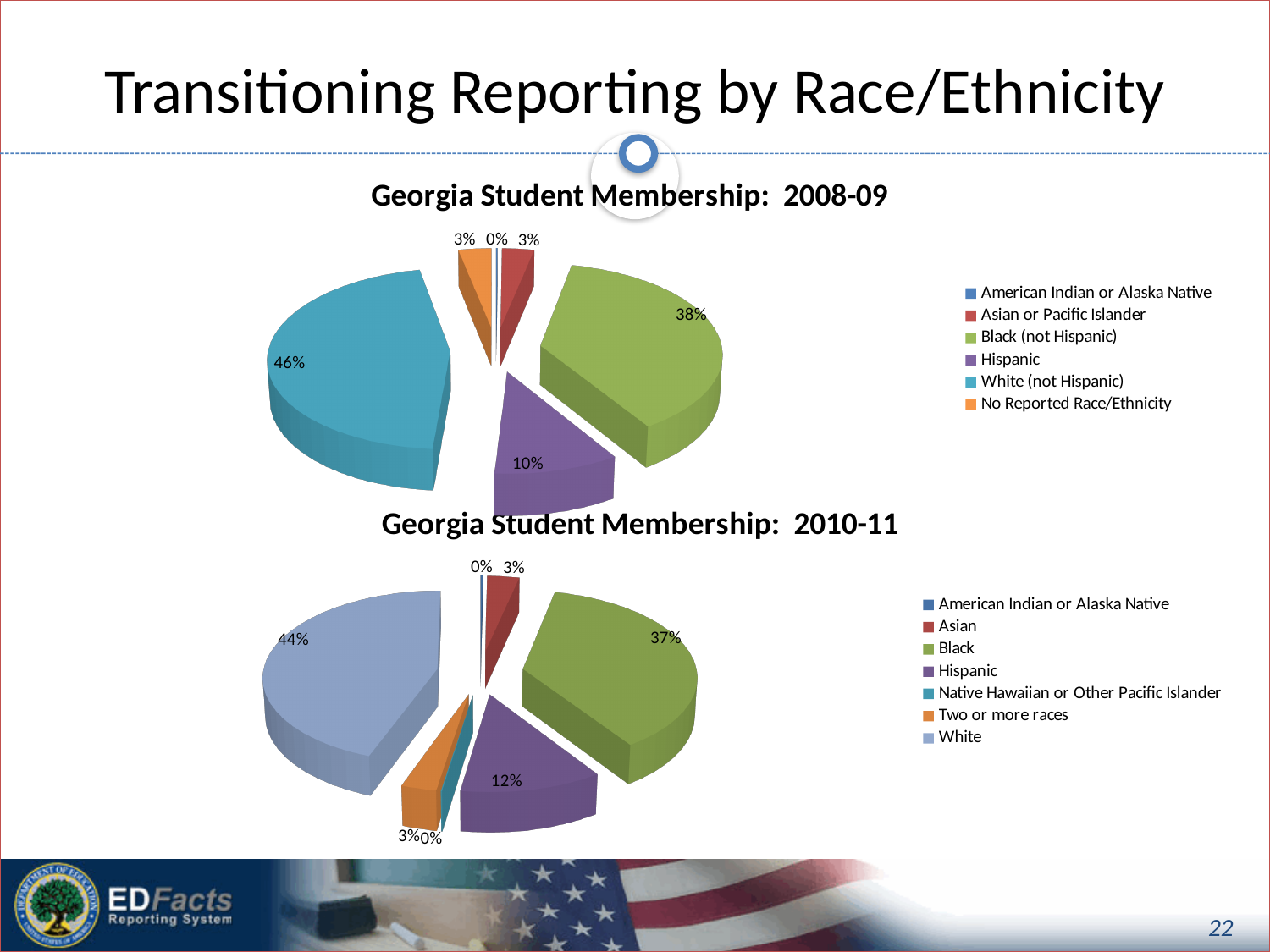
In the 'Georgia Student Membership: 2008-09' chart, what share is Black (not Hispanic)? 38% In the 'Georgia Student Membership: 2008-09' chart, what share is White (not Hispanic)? 46% How many categories does the legend of the 'Georgia Student Membership: 2008-09' chart list? 6 What type of chart is used for 'Georgia Student Membership: 2010-11'? Pie chart How many categories does the legend of the 'Georgia Student Membership: 2010-11' chart list? 7 In the 'Georgia Student Membership: 2010-11' chart, what share is White? 44% In the 'Georgia Student Membership: 2008-09' chart, what share is Hispanic? 10% In the 'Georgia Student Membership: 2010-11' chart, which is larger, the Black share or the Hispanic share? Black In the 'Georgia Student Membership: 2008-09' chart, which category has the largest share? White (not Hispanic) In the 'Georgia Student Membership: 2010-11' chart, what share is Black? 37% In the 'Georgia Student Membership: 2010-11' chart, what share is Hispanic? 12% In the 'Georgia Student Membership: 2008-09' chart, what is the difference between the White (not Hispanic) and Black (not Hispanic) shares? 8%